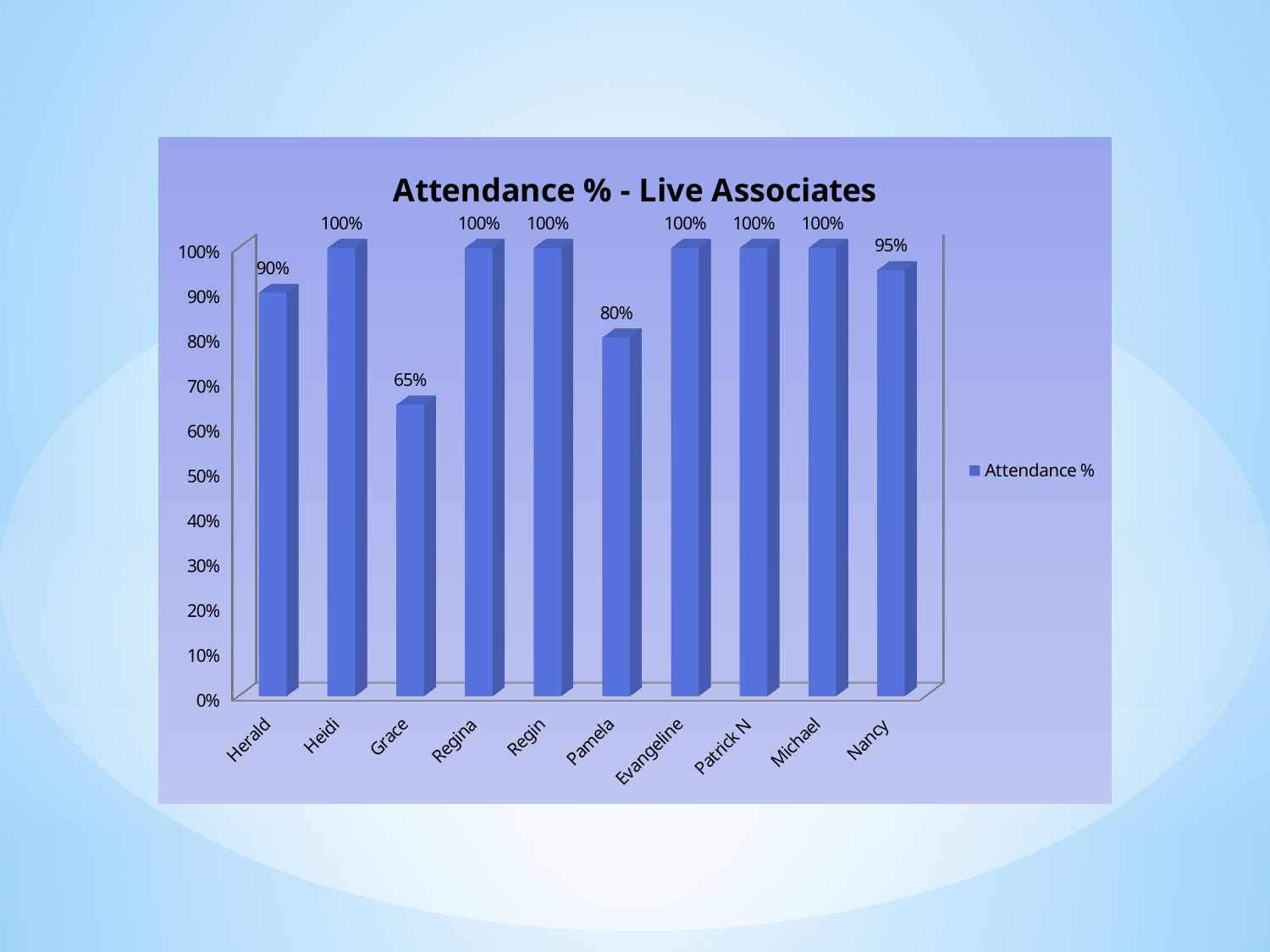
What is the attendance percentage for Pamela? 80% What is the attendance percentage for Herald? 90% What is the attendance percentage for Grace? 65% What is the title of the chart? Attendance % - Live Associates What is the attendance percentage for Nancy? 95% What type of chart is shown on the slide? Bar chart How many associates are shown on the chart? 10 How many associates have an attendance percentage of 100%? 6 What is the difference between Nancy's and Pamela's attendance percentages? 15% Which associate has the lowest attendance percentage? Grace Who has the higher attendance percentage, Herald or Pamela? Herald What is the difference between Heidi's and Grace's attendance percentages? 35%